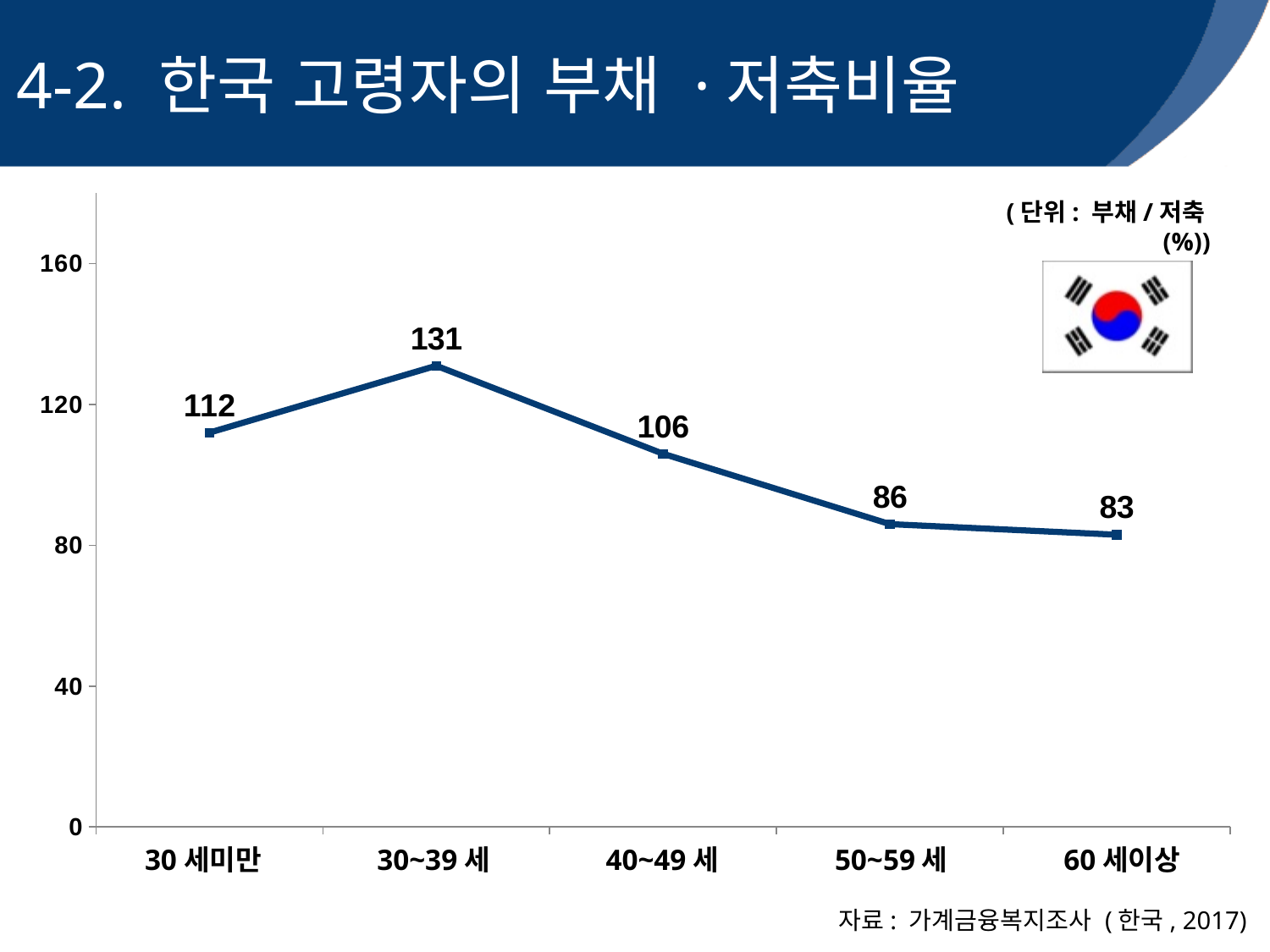
Is the value for 40~49 세 greater or less than 120? less Do the values rise or fall from 30~39 세 to 60 세이상? fall How many age groups are plotted on the chart? 5 What is the value for the 30~39 세 age group? 131 What kind of chart is shown on the slide? line chart What is the value for the 30 세미만 age group? 112 Which age group has the highest value? 30~39 세 Which age group has the lowest value? 60 세이상 Which is larger, the value for 30 세미만 or the value for 50~59 세? 30 세미만 What is the difference between the values for 30~39 세 and 40~49 세? 25 What is the difference between the values for 30 세미만 and 60 세이상? 29 What is the value for the 60 세이상 age group? 83